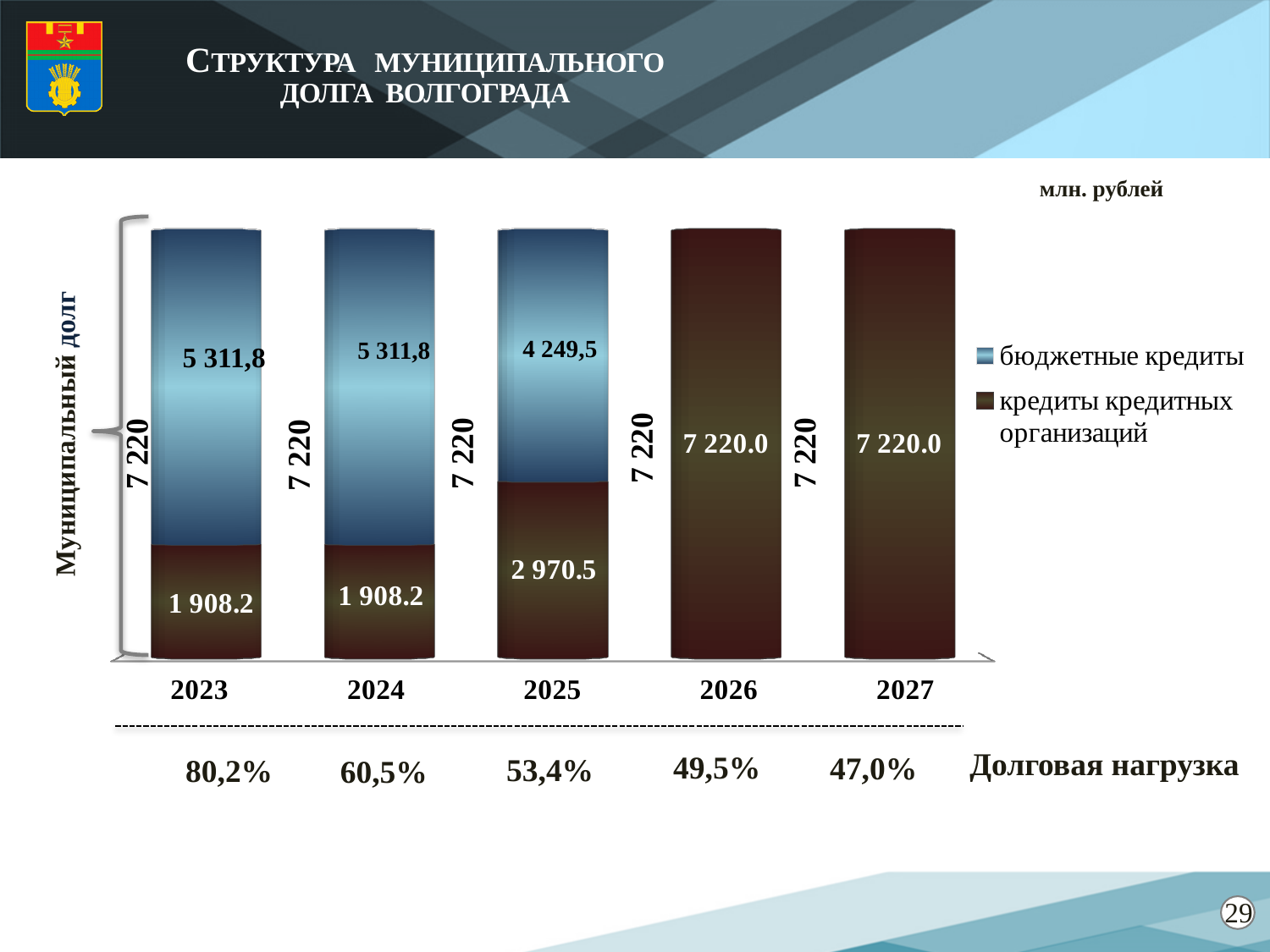
What is the value of кредиты кредитных организаций for 2027? 7 220.0 In which year is the value of кредиты кредитных организаций lowest? 2023 and 2024 How many series does the legend list? 2 What is the value of бюджетные кредиты for 2023? 5 311,8 What is the total municipal debt shown for the 2024 bar? 7 220 What kind of chart is shown on the slide? stacked bar chart How many years are shown on the x axis? 5 Which is larger in 2025: бюджетные кредиты or кредиты кредитных организаций? бюджетные кредиты What is the difference between кредиты кредитных организаций in 2025 and in 2024? 1 062.3 What is the Долговая нагрузка value shown for 2026? 49,5% What is the value of бюджетные кредиты for 2025? 4 249,5 What is the value of кредиты кредитных организаций for 2025? 2 970.5